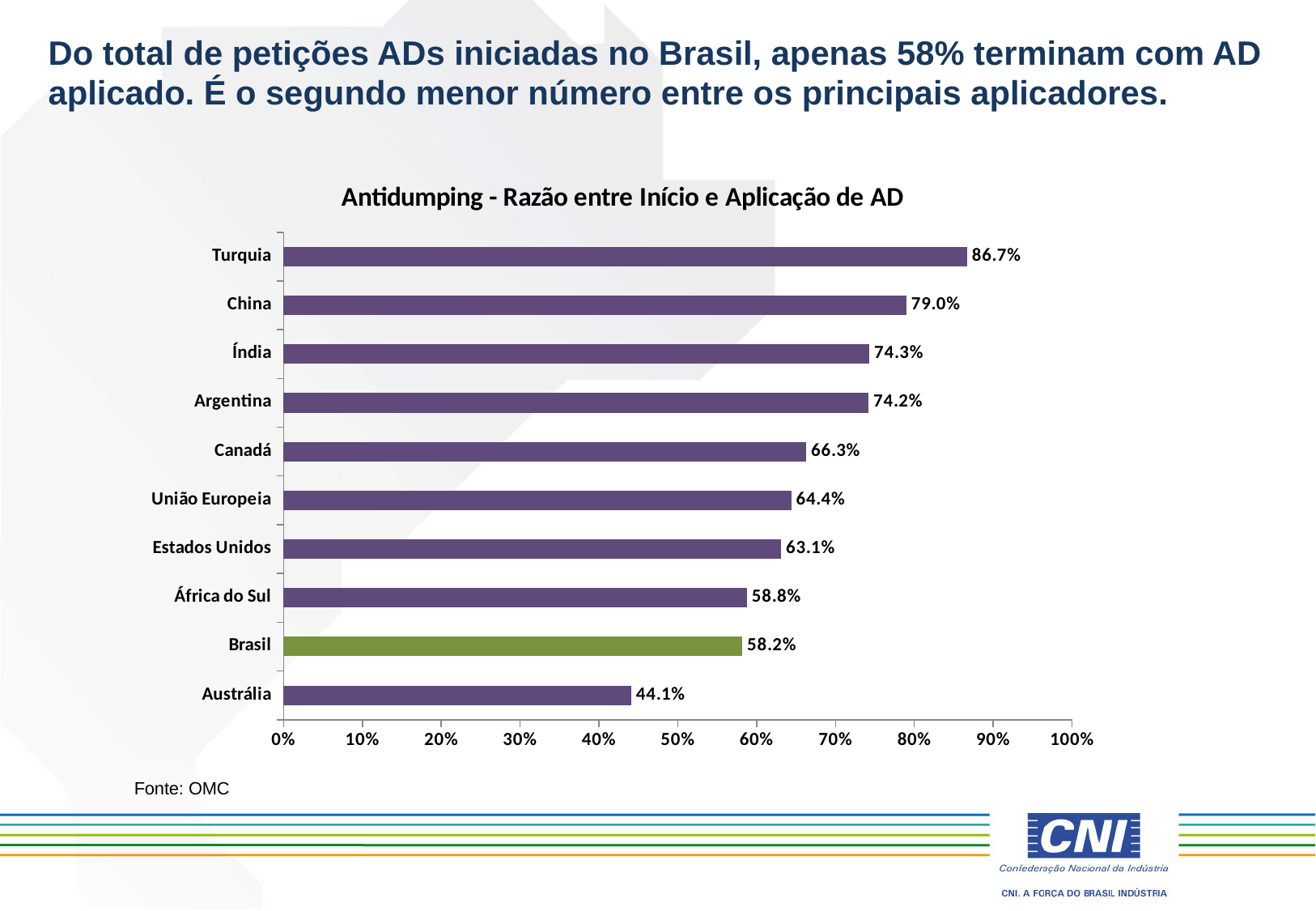
What is the value for Turquia? 86.7% What is the value for Brasil? 58.2% Is the value for Austrália greater or less than 50%? less Which country has the lowest value? Austrália What is the title of the chart? Antidumping - Razão entre Início e Aplicação de AD How many countries are shown in the chart? 10 What is the difference between the values for Turquia and Austrália? 42.6% What kind of chart is shown on the slide? bar chart Which is larger, the value for Estados Unidos or the value for União Europeia? União Europeia Which country has the highest value? Turquia What is the difference between the values for China and Brasil? 20.8% What is the value for Canadá? 66.3%